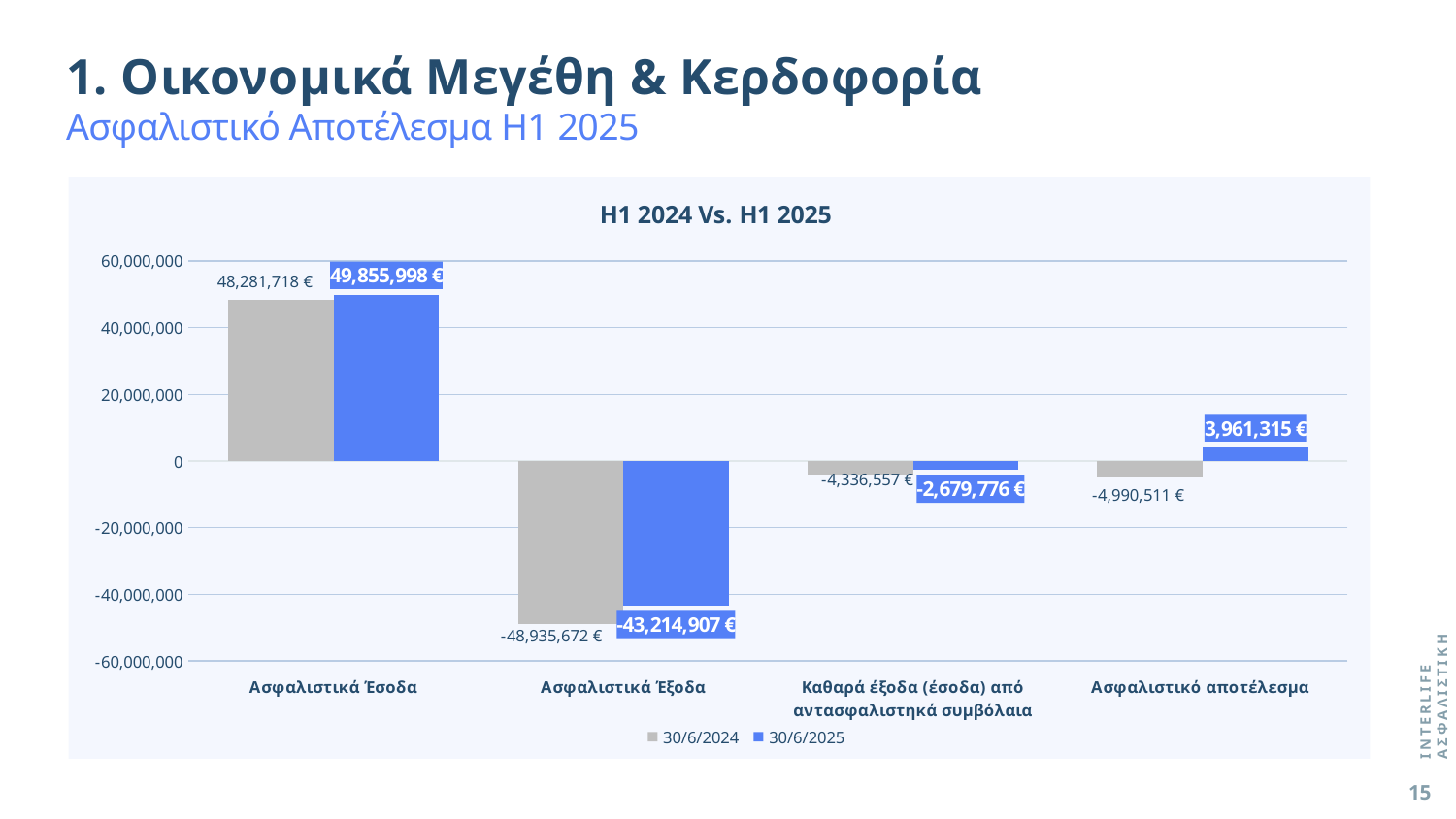
What is the value for Ασφαλιστικά Έσοδα in the 30/6/2025 series? 49,855,998 € Which category has the highest value in the 30/6/2025 series? Ασφαλιστικά Έσοδα What is the difference between the 30/6/2025 and 30/6/2024 values for Ασφαλιστικά Έσοδα? 1,574,280 € For Ασφαλιστικό αποτέλεσμα, which series has the larger value, 30/6/2024 or 30/6/2025? 30/6/2025 Which category has the lowest value in the 30/6/2024 series? Ασφαλιστικά Έξοδα What is the value for Καθαρά έξοδα (έσοδα) από αντασφαλιστηκά συμβόλαια in the 30/6/2024 series? -4,336,557 € What is the value for Ασφαλιστικό αποτέλεσμα in the 30/6/2025 series? 3,961,315 € How many series does the legend list? 2 What is the value for Ασφαλιστικά Έξοδα in the 30/6/2024 series? -48,935,672 € What is the difference between the 30/6/2025 and 30/6/2024 values for Ασφαλιστικό αποτέλεσμα? 8,951,826 € How many categories are shown on the x axis of the chart? 4 What type of chart is shown on the slide? Bar chart